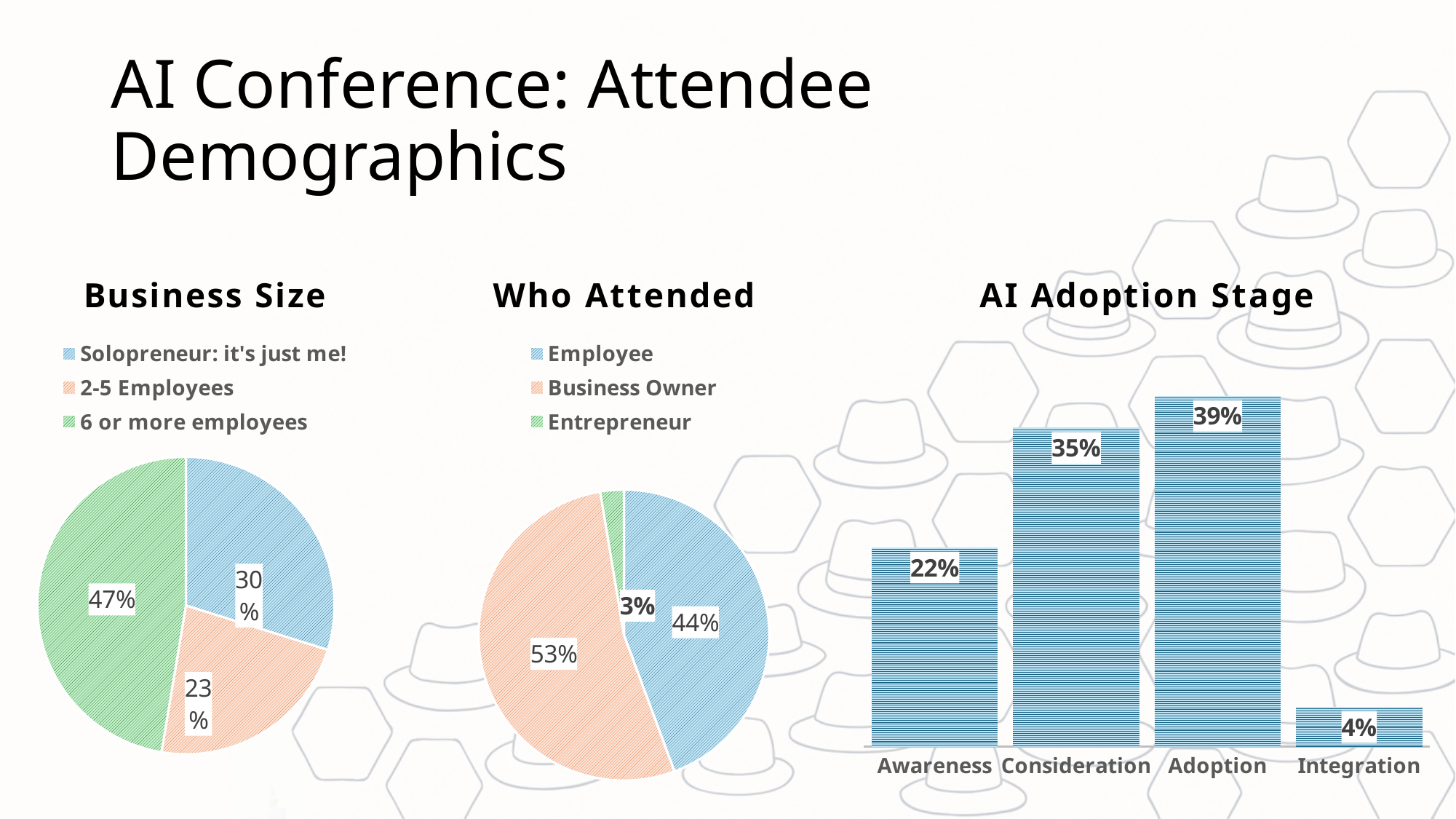
In the Who Attended chart, which is larger: Employee or Business Owner? Business Owner In the Business Size chart, what is the difference between the share for 6 or more employees and the share for 2-5 Employees? 24% In the AI Adoption Stage chart, what is the difference between Adoption and Awareness? 17% In the Business Size chart, what share of attendees are solopreneurs? 30% In the AI Adoption Stage chart, which stage has the highest value? Adoption In the Who Attended chart, how many categories does the legend list? 3 In the AI Adoption Stage chart, what is the value for Consideration? 35% What kind of chart is the AI Adoption Stage chart? Bar chart In the Business Size chart, which category has the smallest share? 2-5 Employees In the Who Attended chart, which category has the smallest share? Entrepreneur In the Business Size chart, which category has the largest share? 6 or more employees In the Who Attended chart, what share of attendees are Business Owners? 53%